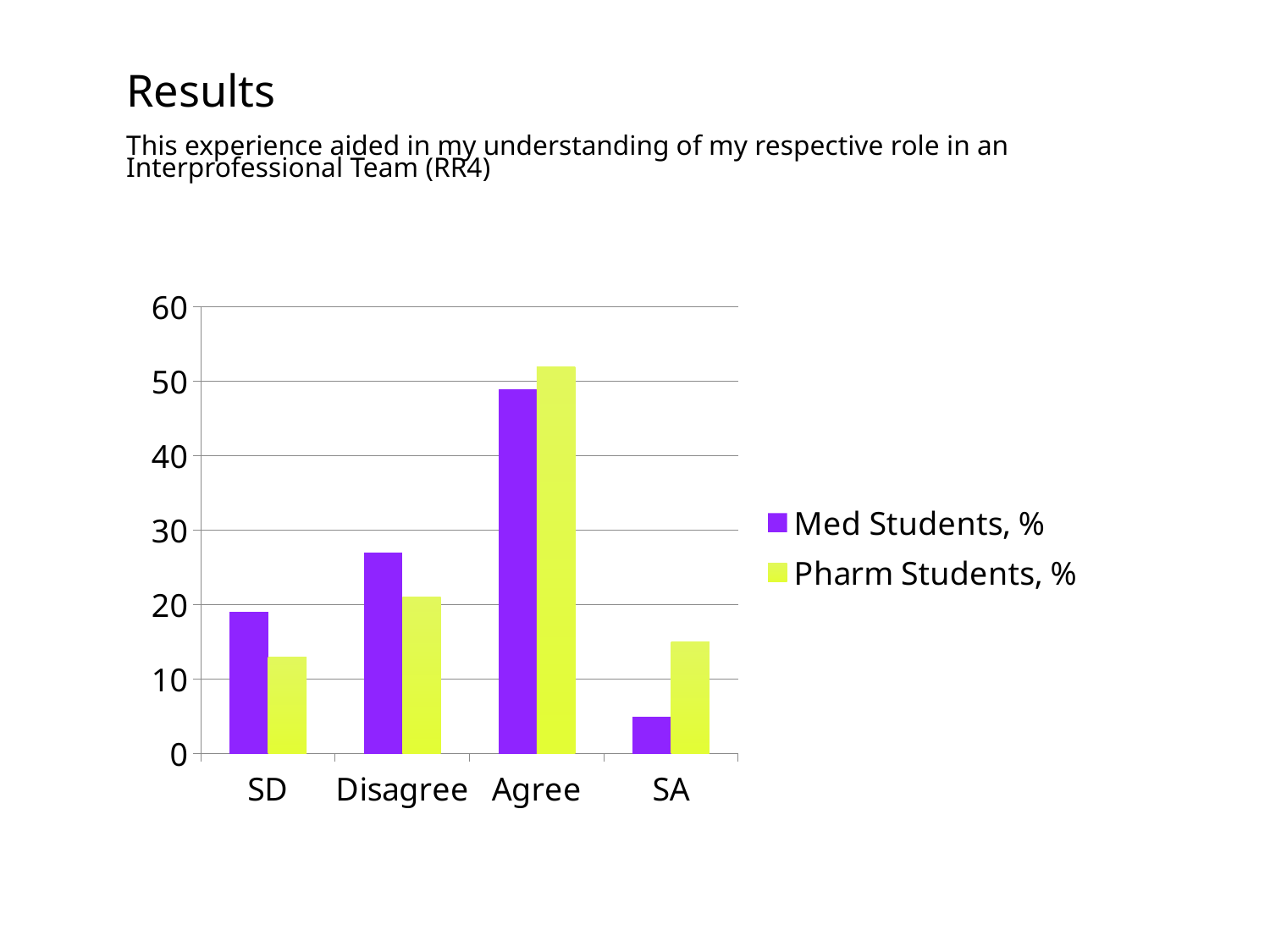
Which series is shown in purple in the legend? Med Students, % Is the value for Med Students, % in the SA category greater or less than 10? less Which category has the highest value for Pharm Students, %? Agree Which category has the highest value for Med Students, %? Agree Is the value for Pharm Students, % in the Disagree category greater or less than 30? less Is the value for Med Students, % in the Agree category greater or less than 40? greater Which category has the lowest value for Pharm Students, %? SD What kind of chart is shown on the slide? bar chart How many series does the legend list? 2 How many categories are shown on the x axis? 4 Which category has the lowest value for Med Students, %? SA In the SA category, which series has the larger value, Med Students, % or Pharm Students, %? Pharm Students, %